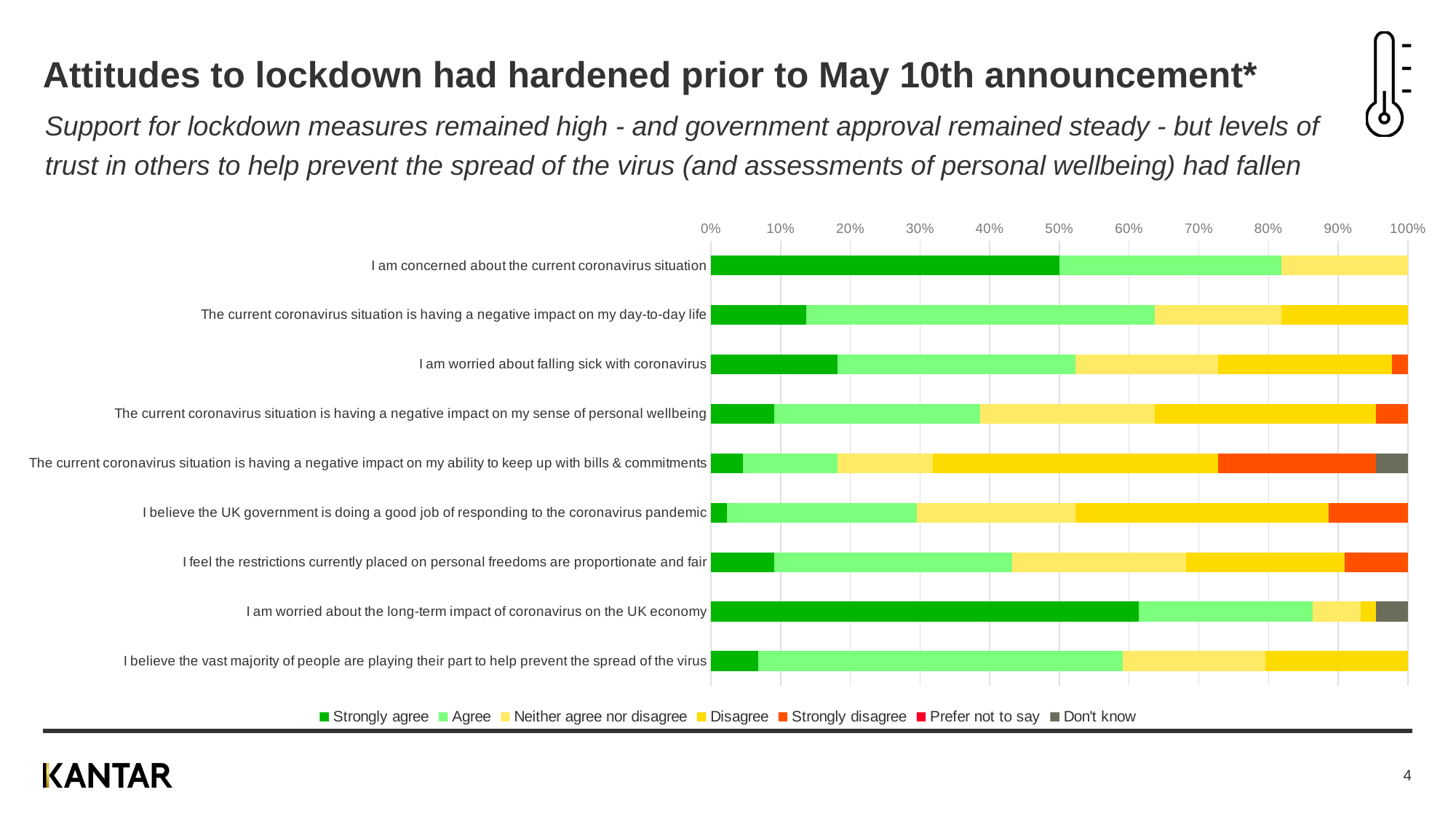
What is the first series listed in the chart legend? Strongly agree What kind of chart is shown on the slide? Stacked bar chart Is the Strongly agree value for 'I am concerned about the current coronavirus situation' greater or less than 40%? greater Which statement has the largest Strongly agree segment? I am worried about the long-term impact of coronavirus on the UK economy How many statements (categories) are plotted in the chart? 9 How many series does the chart legend list? 7 Is the Strongly agree value for 'The current coronavirus situation is having a negative impact on my day-to-day life' greater or less than 20%? less What is the highest value shown on the percentage axis of the chart? 100% Which statement has a larger Strongly agree segment: 'I am concerned about the current coronavirus situation' or 'I am worried about falling sick with coronavirus'? I am concerned about the current coronavirus situation Is the Strongly agree value for 'I am worried about the long-term impact of coronavirus on the UK economy' greater or less than 50%? greater Which statement has a larger Strongly disagree segment: 'The current coronavirus situation is having a negative impact on my ability to keep up with bills & commitments' or 'I am worried about falling sick with coronavirus'? The current coronavirus situation is having a negative impact on my ability to keep up with bills & commitments Which statement has the smallest Strongly agree segment? I believe the UK government is doing a good job of responding to the coronavirus pandemic